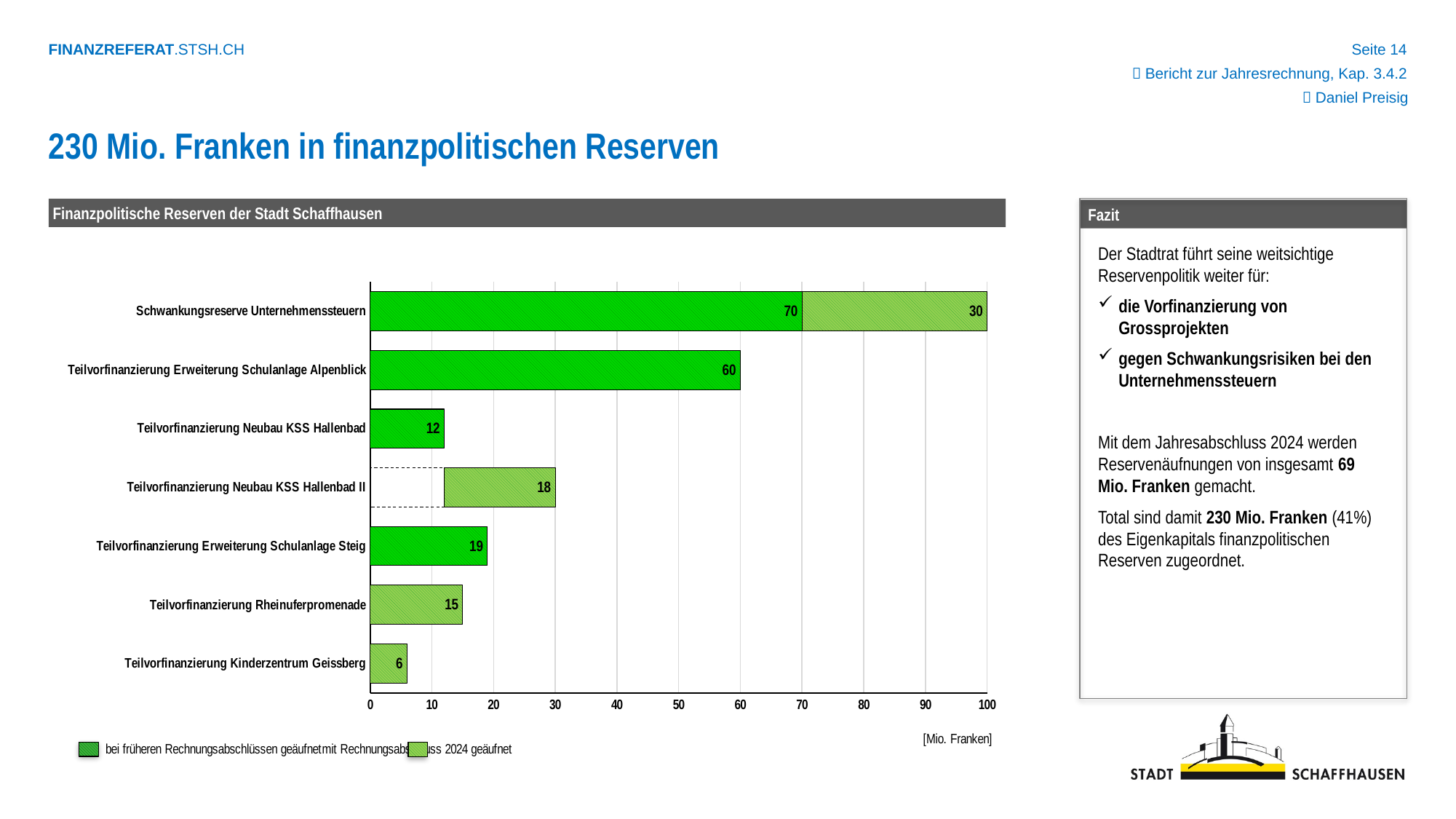
What is the value of the dark green segment (bei früheren Rechnungsabschlüssen geäufnet) for Schwankungsreserve Unternehmenssteuern? 70 Which category has the lowest value in the chart? Teilvorfinanzierung Kinderzentrum Geissberg What is the difference between the values for Teilvorfinanzierung Erweiterung Schulanlage Steig and Teilvorfinanzierung Rheinuferpromenade? 4 Which category has the highest total value in the chart? Schwankungsreserve Unternehmenssteuern What is the value for Teilvorfinanzierung Kinderzentrum Geissberg? 6 How many categories are plotted in the chart? 7 How many series does the legend list? 2 What is the value of the light green segment (mit Rechnungsabschluss 2024 geäufnet) for Schwankungsreserve Unternehmenssteuern? 30 Which is larger: the value for Teilvorfinanzierung Neubau KSS Hallenbad II or for Teilvorfinanzierung Neubau KSS Hallenbad? Teilvorfinanzierung Neubau KSS Hallenbad II What is the value for Teilvorfinanzierung Erweiterung Schulanlage Alpenblick? 60 What is the total of the stacked bar for Schwankungsreserve Unternehmenssteuern? 100 What type of chart is shown under the title "Finanzpolitische Reserven der Stadt Schaffhausen"? bar chart